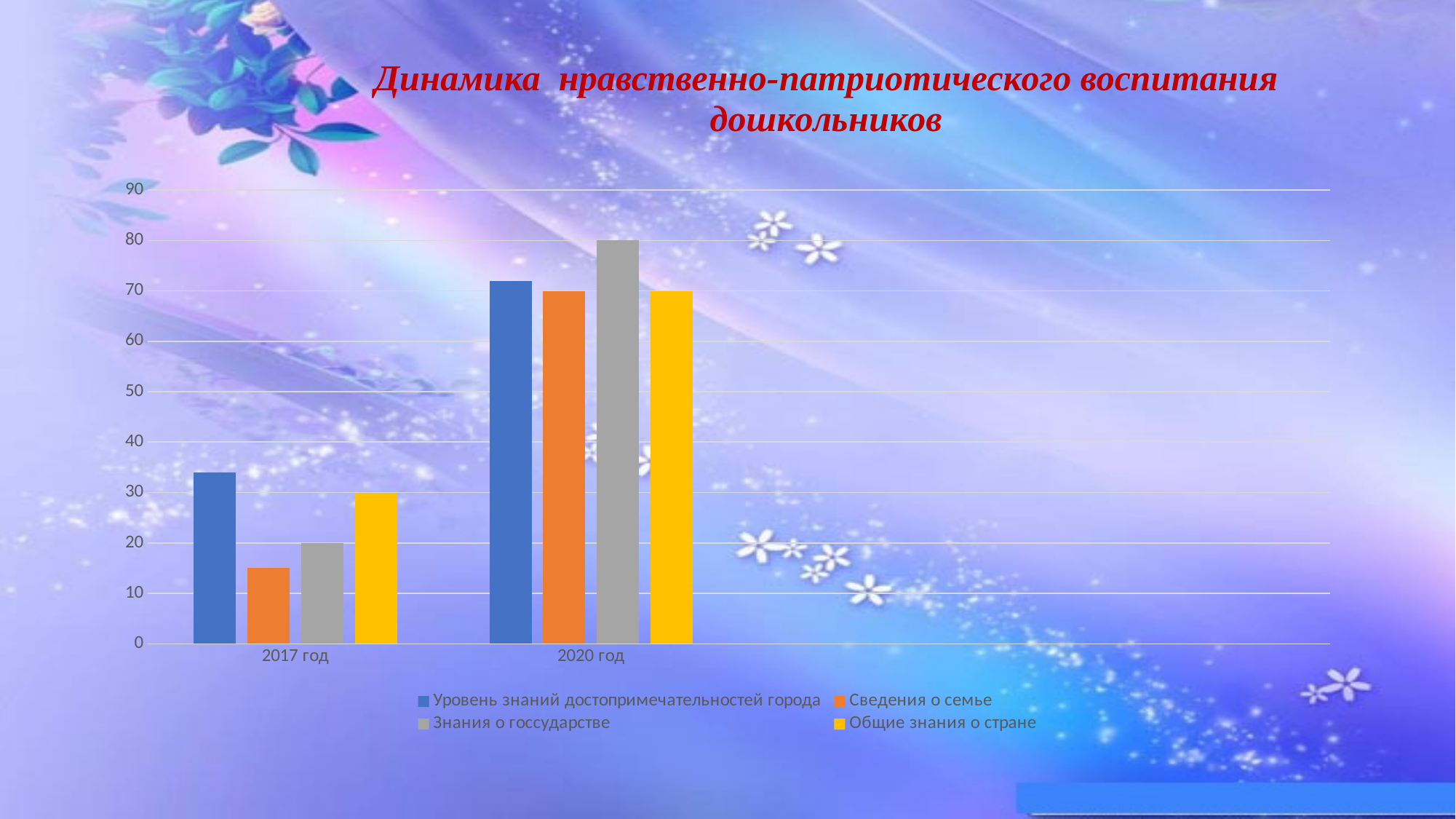
What is the value for Знания о государстве in 2017 год? 20 Is the value for Сведения о семье in 2017 год greater or less than 20? less Which series has the highest value in 2020 год? Знания о государстве How many categories (years) are shown on the x axis? 2 What is the value for Знания о государстве in 2020 год? 80 Do the values for each series rise or fall from 2017 год to 2020 год? rise How many series does the legend list? 4 Which series has the lowest value in 2017 год? Сведения о семье By how much did the value for Знания о государстве increase from 2017 год to 2020 год? 60 What kind of chart is shown on the slide? bar chart What is the value for Общие знания о стране in 2017 год? 30 Is the value for Уровень знаний достопримечательностей города in 2017 год greater or less than 30? greater